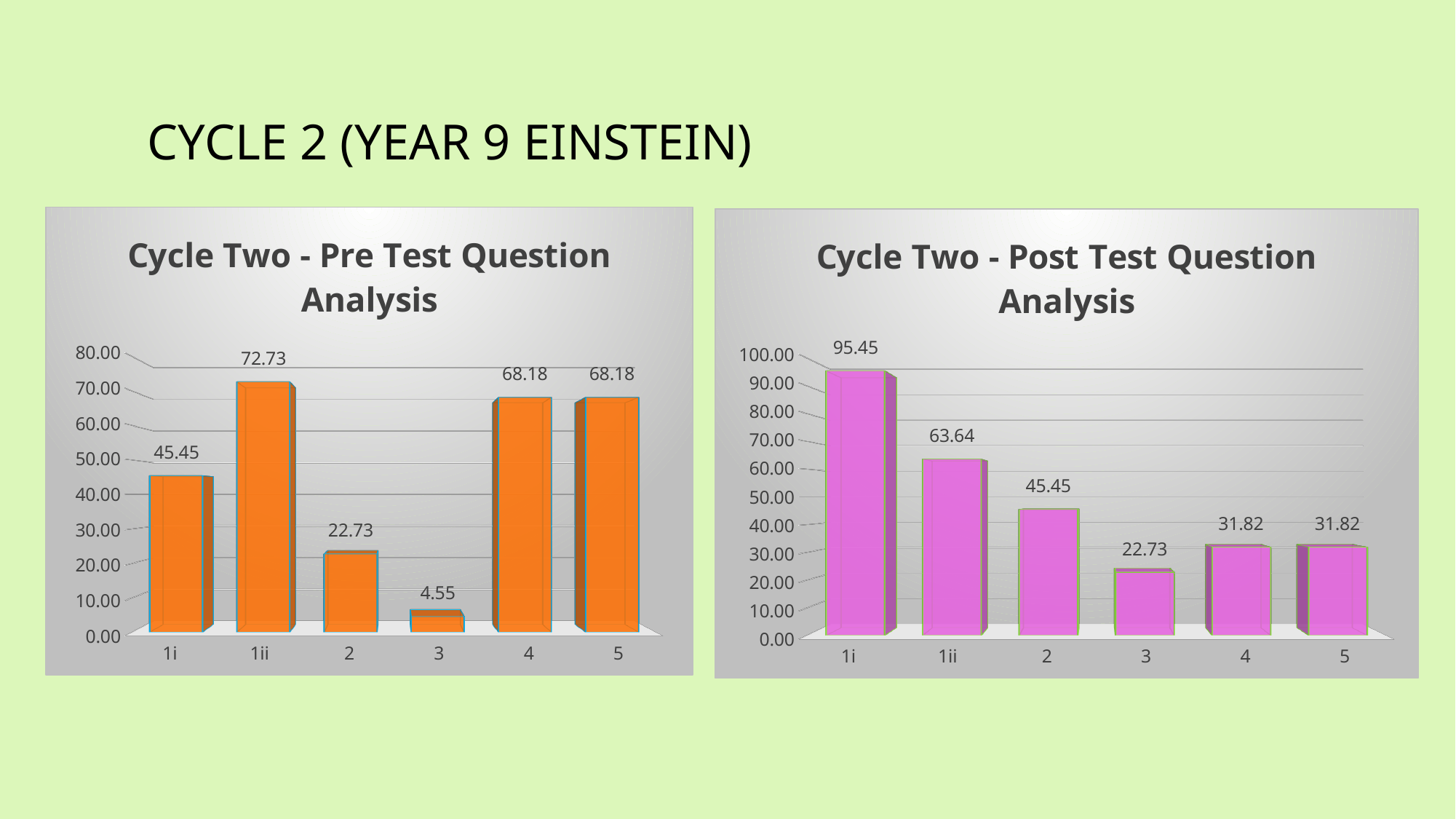
In the 'Cycle Two - Post Test Question Analysis' chart, which is larger, the value for question 1ii or question 2? 1ii What colour are the bars in the 'Cycle Two - Pre Test Question Analysis' chart? Orange What kind of chart is the 'Cycle Two - Post Test Question Analysis' chart? Bar chart In the 'Cycle Two - Post Test Question Analysis' chart, what is the difference between the values for question 1i and question 1ii? 31.81 In the 'Cycle Two - Pre Test Question Analysis' chart, how many questions are shown on the x axis? 6 In the 'Cycle Two - Pre Test Question Analysis' chart, which question has the lowest value? 3 In the 'Cycle Two - Post Test Question Analysis' chart, what is the value for question 3? 22.73 In the 'Cycle Two - Pre Test Question Analysis' chart, what is the value for question 1ii? 72.73 In the 'Cycle Two - Pre Test Question Analysis' chart, which question has the highest value? 1ii In the 'Cycle Two - Post Test Question Analysis' chart, which question has the highest value? 1i In the 'Cycle Two - Post Test Question Analysis' chart, what is the value for question 1i? 95.45 In the 'Cycle Two - Pre Test Question Analysis' chart, what is the difference between the values for question 1ii and question 1i? 27.28